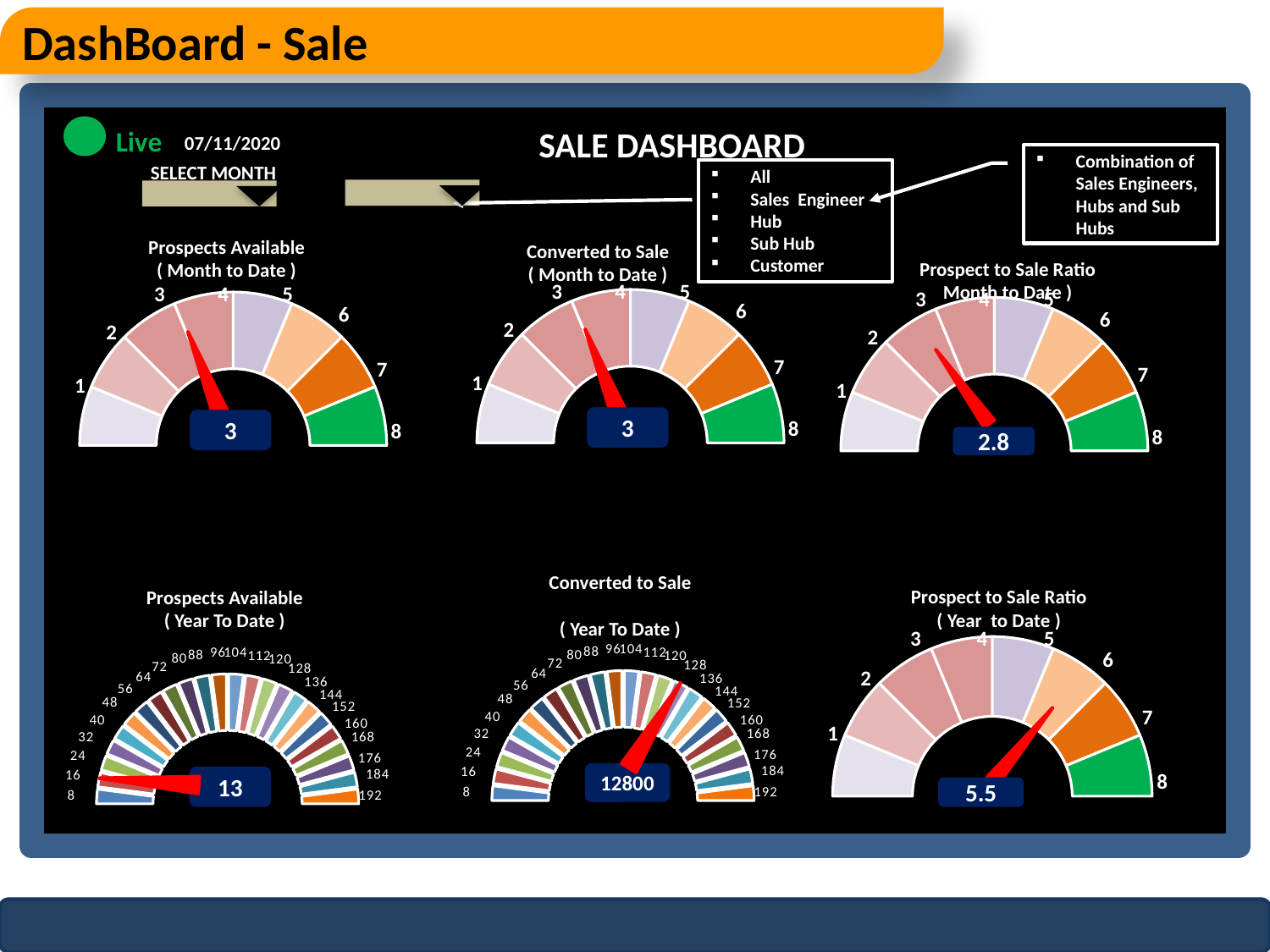
How many gauge charts are shown on the slide? 6 On the 'Converted to Sale (Year To Date)' gauge, what value is displayed? 12800 On the 'Prospects Available (Year To Date)' gauge, what value is displayed? 13 On the 'Converted to Sale (Month to Date)' gauge, what value is displayed? 3 On the 'Prospect to Sale Ratio (Year to Date)' gauge, what value is displayed? 5.5 What is the difference between the Prospect to Sale Ratio (Year to Date) value and the Prospect to Sale Ratio (Month to Date) value? 2.7 Which is larger: the Prospect to Sale Ratio for Year to Date or for Month to Date? Year to Date What kind of chart is used for 'Prospects Available (Month to Date)'? Gauge chart On the 'Converted to Sale (Year To Date)' gauge, what is the highest scale label shown? 192 On the 'Prospect to Sale Ratio (Month to Date)' gauge, what value is displayed? 2.8 On the 'Prospects Available (Month to Date)' gauge, what value is displayed? 3 On the 'Prospects Available (Month to Date)' gauge, what is the highest scale label shown? 8